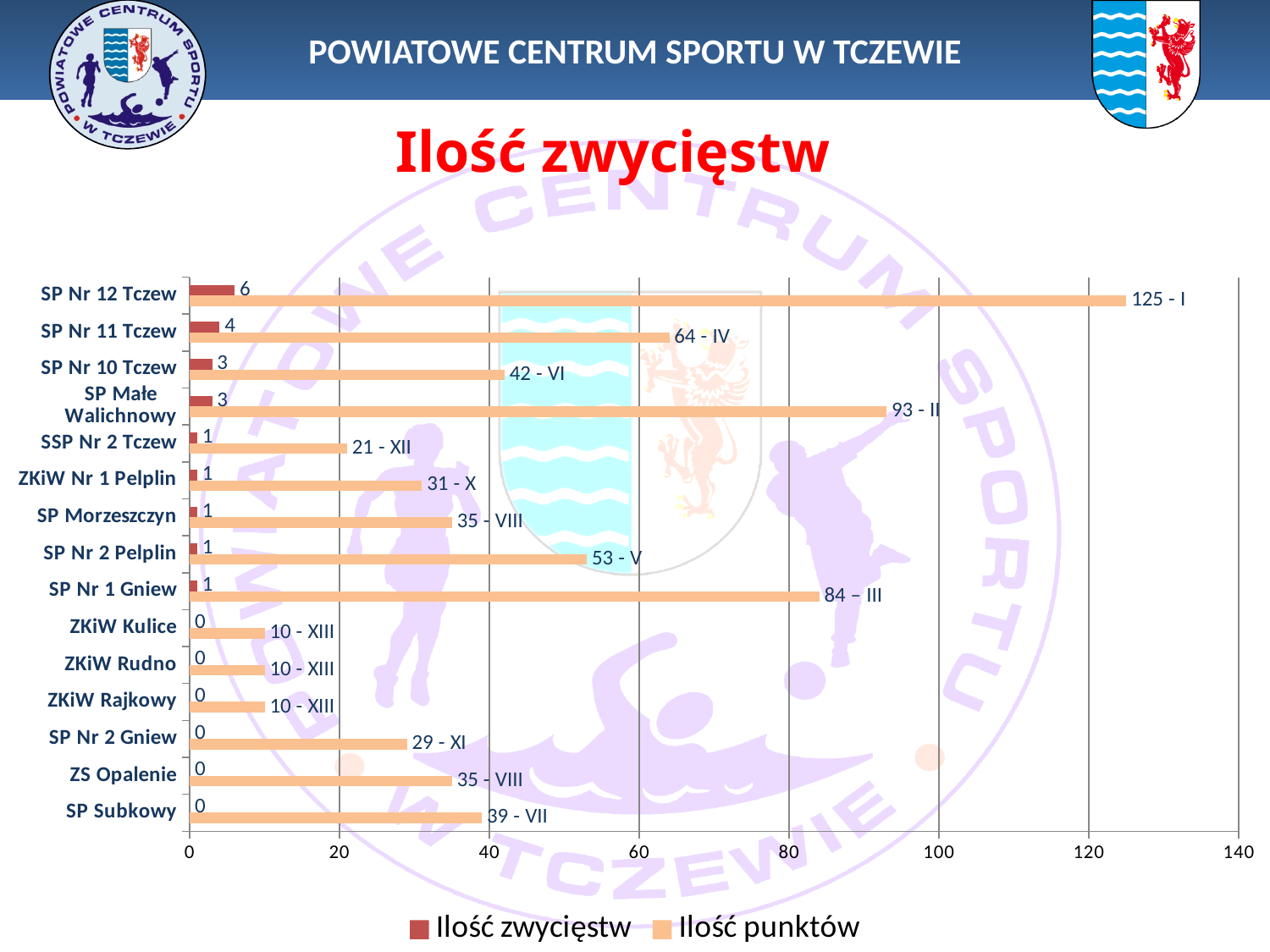
What type of chart is shown on the slide? bar chart How many series does the legend list? 2 Is the Ilość punktów value for SP Nr 10 Tczew greater or less than 60? less How many schools (categories) are shown on the chart? 15 What is the difference in Ilość punktów between SP Nr 12 Tczew (125) and SP Nr 11 Tczew (64)? 61 What is the value of Ilość zwycięstw for SP Nr 12 Tczew? 6 Which has more Ilość punktów: SP Nr 1 Gniew or SP Nr 2 Pelplin? SP Nr 1 Gniew Which school has the highest Ilość punktów? SP Nr 12 Tczew What is the data label for Ilość punktów for SP Małe Walichnowy? 93 - II What is the title of the chart? Ilość zwycięstw What is the value of Ilość zwycięstw for SP Nr 11 Tczew? 4 Which school has the highest Ilość zwycięstw? SP Nr 12 Tczew